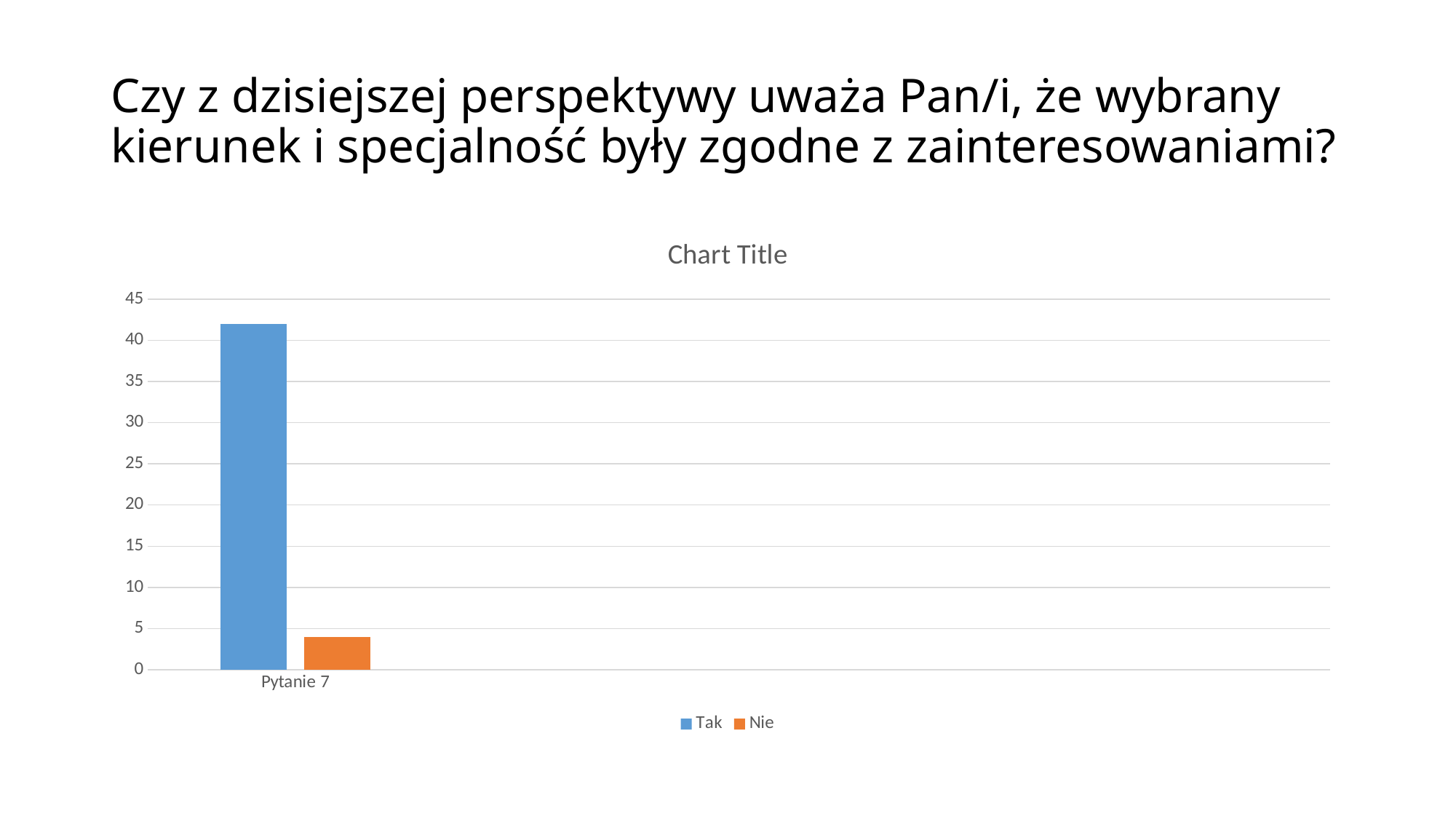
What colour is the bar for the Nie series? orange Which is larger for Pytanie 7, Tak or Nie? Tak How many series does the chart legend list? 2 How many categories are shown on the x axis of the chart? 1 Which series has the highest value for Pytanie 7? Tak Is the value for Nie greater or less than 10? less Is the value for Nie greater or less than 5? less Is the value for Tak greater or less than 40? greater Which series has the lowest value for Pytanie 7? Nie What is the title shown above the chart? Chart Title What kind of chart is shown on the slide? bar chart